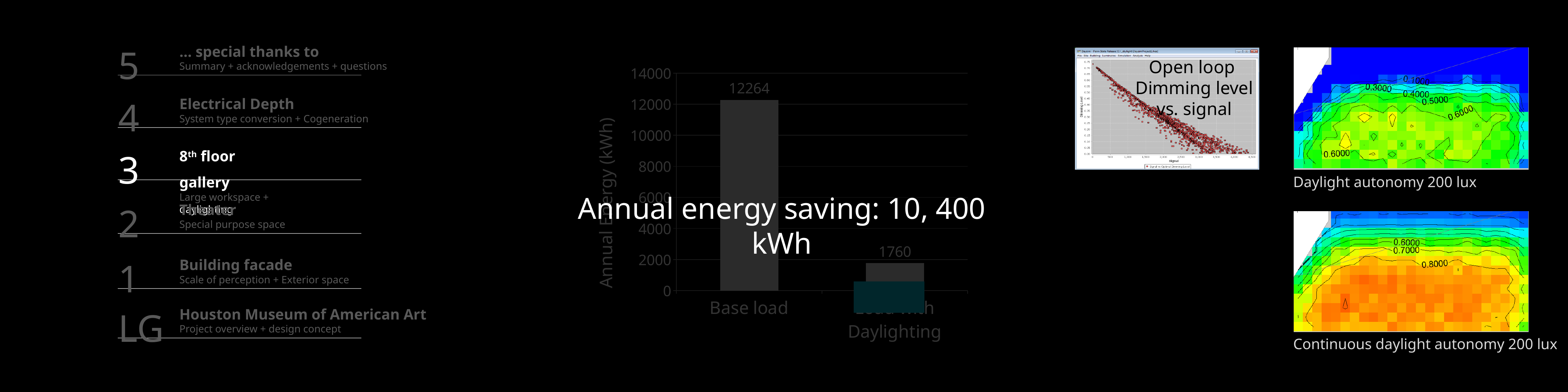
What is the value for Load with Daylighting in the bar chart? 1760 Which category has the highest value in the bar chart? Base load What annual energy saving is stated in the text over the bar chart? 10, 400 kWh What kind of chart shows Base load and Load with Daylighting? bar chart Is the value for Load with Daylighting greater or less than 2000? less What is the value for Base load in the bar chart? 12264 Which is larger in the bar chart, Base load or Load with Daylighting? Base load Which category has the lowest value in the bar chart? Load with Daylighting Is the value for Base load greater or less than 12000? greater How many categories are shown in the bar chart? 2 What is the y-axis title of the bar chart? Annual Energy (kWh)